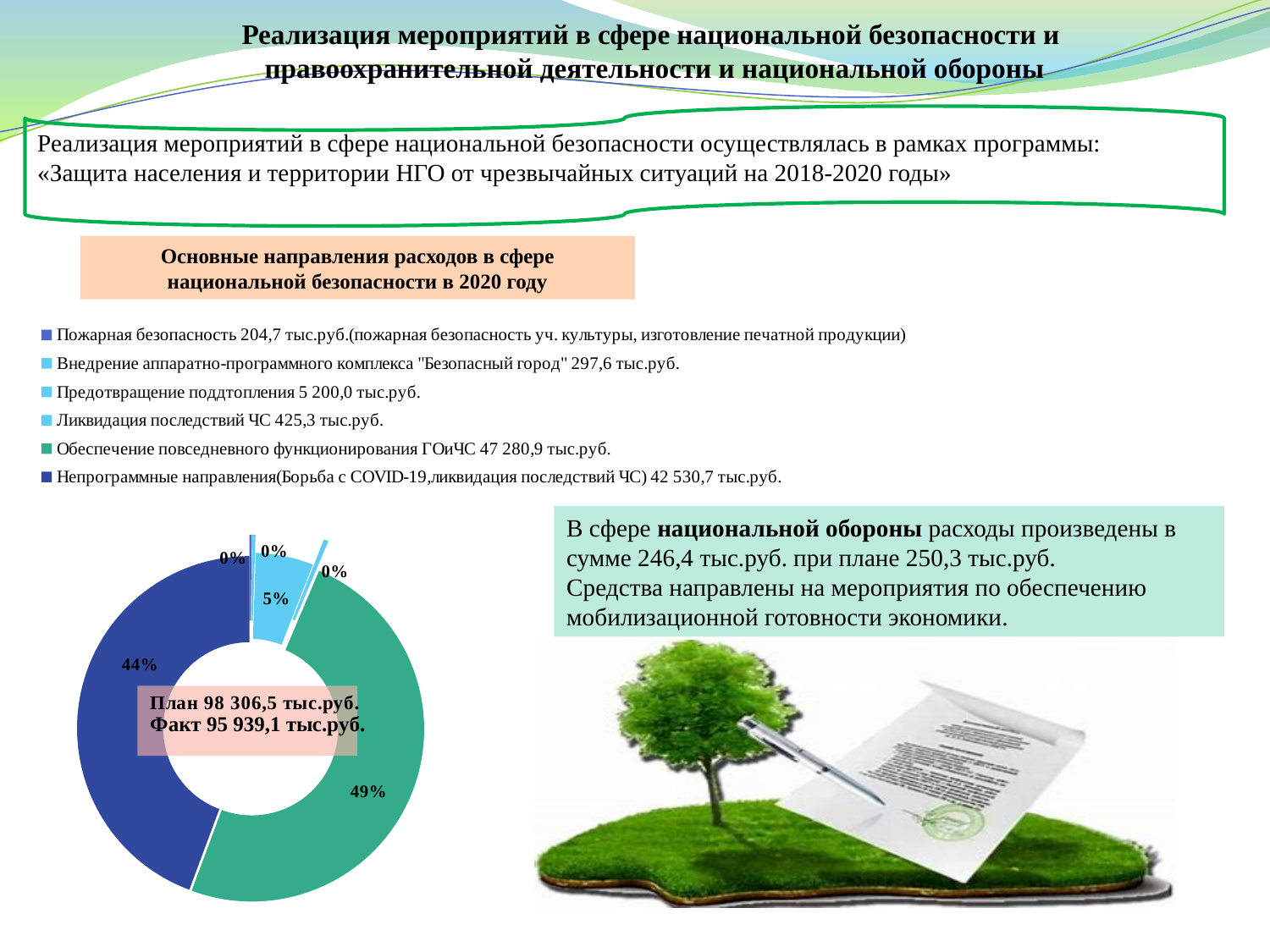
How many slices does the doughnut chart have? 6 Which category has the largest share of the doughnut chart? Обеспечение повседневного функционирования ГОиЧС What kind of chart is shown on the slide? Doughnut (pie) chart What share of the chart does Непрограммные направления account for? 44% What plan value is printed in the centre of the doughnut chart? 98 306,5 тыс.руб. Which is larger: the share for Обеспечение повседневного функционирования ГОиЧС or the share for Непрограммные направления? Обеспечение повседневного функционирования ГОиЧС What is the difference in percentage points between the 49% slice and the 44% slice? 5 percentage points What share of the chart does Предотвращение подтопления account for? 5% What is the title of the chart? Основные направления расходов в сфере национальной безопасности в 2020 году According to the legend, what amount is given for Пожарная безопасность? 204,7 тыс.руб. What share of the chart does Обеспечение повседневного функционирования ГОиЧС account for? 49% How many entries does the chart legend list? 6